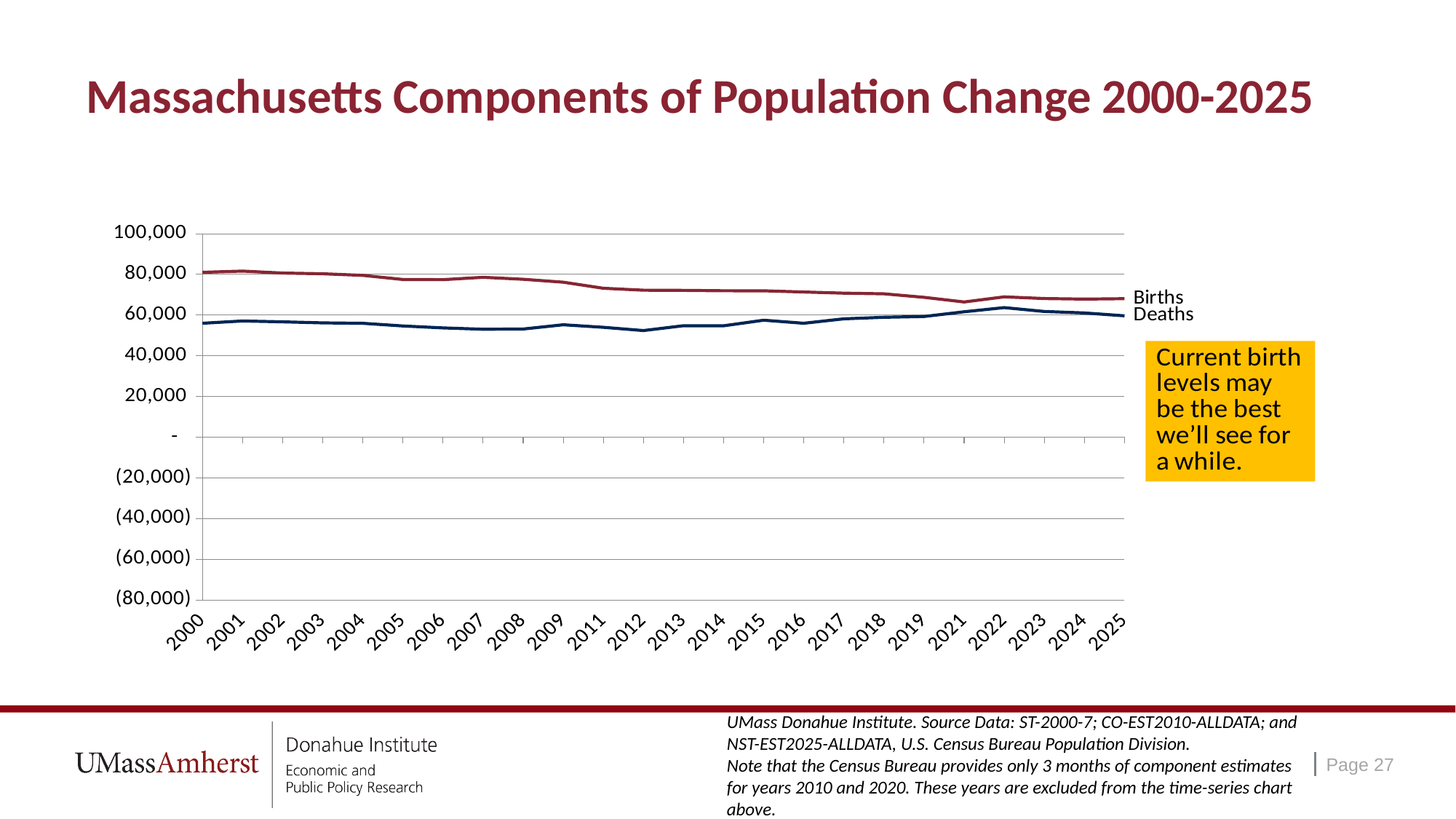
In which year does the Deaths series reach its highest value? 2022 What kind of chart is shown on the slide? Line chart Is the value for Births in 2005 greater or less than 60,000? greater How many years are labelled along the x axis of the chart? 24 Is the value for Deaths in 2012 greater or less than 60,000? less What is the title of the chart? Massachusetts Components of Population Change 2000-2025 How many series are plotted on the chart? 2 What are the names of the two series plotted on the chart? Births and Deaths Is the value for Births in 2025 greater or less than 80,000? less Do the Births values generally rise or fall from 2000 to 2025? Fall In 2000, which is larger, Births or Deaths? Births Which two years are missing from the x axis between 2000 and 2025? 2010 and 2020